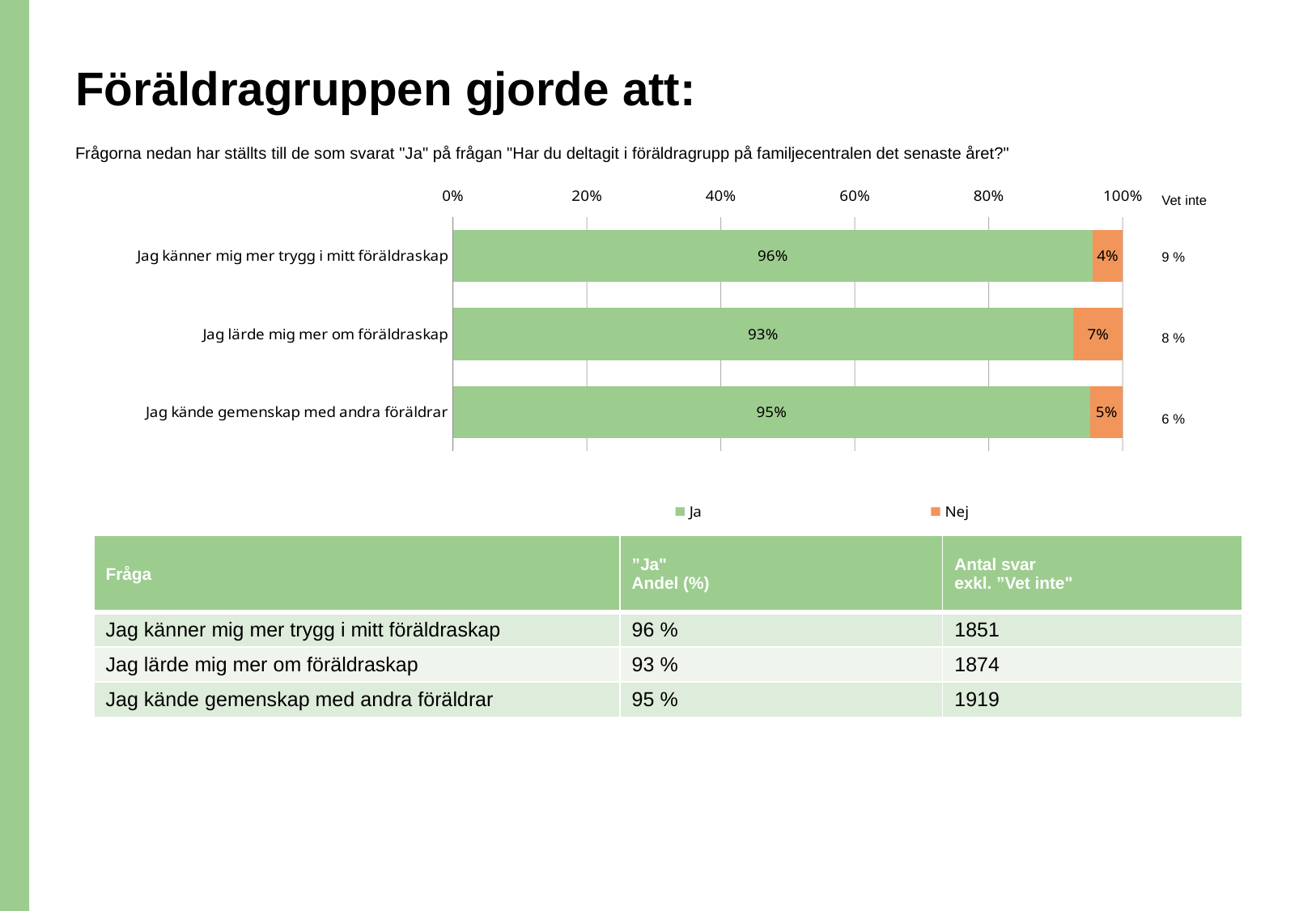
What is the "Ja" value for "Jag kände gemenskap med andra föräldrar"? 95% Which category has the lowest "Ja" value? Jag lärde mig mer om föräldraskap Which is larger: the "Nej" value for "Jag kände gemenskap med andra föräldrar" or for "Jag lärde mig mer om föräldraskap"? Jag lärde mig mer om föräldraskap What kind of chart is shown on the slide? Stacked bar chart What is the total of the stacked bar for "Jag lärde mig mer om föräldraskap"? 100% How many categories are shown in the chart? 3 Which series is shown in orange in the chart? Nej How many series does the legend list? 2 What is the "Nej" value for "Jag lärde mig mer om föräldraskap"? 7% What is the difference between the "Ja" values for "Jag känner mig mer trygg i mitt föräldraskap" and "Jag lärde mig mer om föräldraskap"? 3% Which category has the highest "Ja" value? Jag känner mig mer trygg i mitt föräldraskap What is the "Ja" value for "Jag känner mig mer trygg i mitt föräldraskap"? 96%